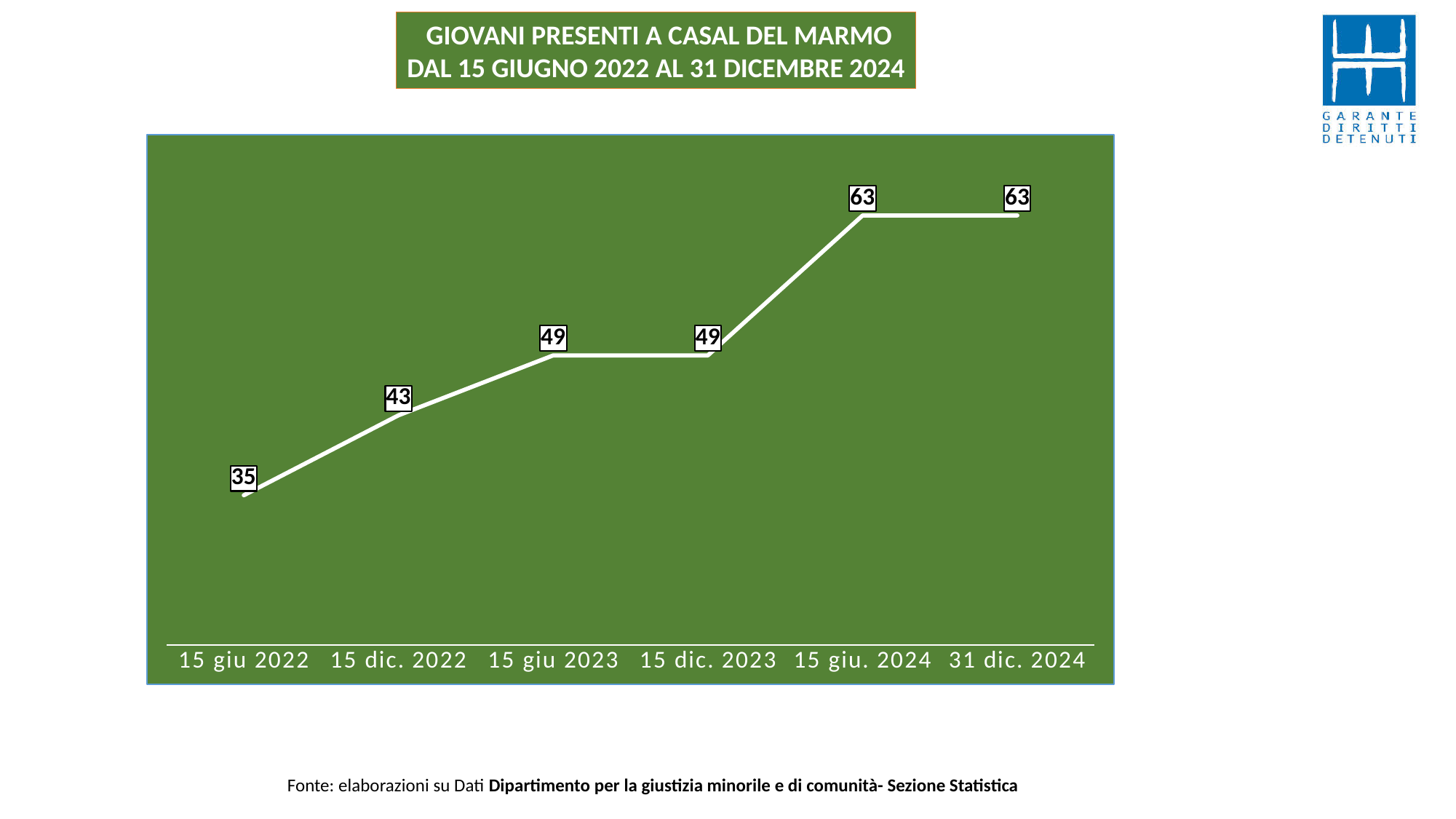
Do the values rise or fall from 15 giu 2022 to 31 dic. 2024? rise Which date has the lowest value? 15 giu 2022 What is the value for 15 dic. 2022? 43 What kind of chart is shown on the slide? line chart What is the value for 15 giu 2023? 49 Which is larger, the value for 15 dic. 2022 or the value for 15 giu 2023? 15 giu 2023 How many data points are plotted on the chart? 6 What is the title of the chart? GIOVANI PRESENTI A CASAL DEL MARMO DAL 15 GIUGNO 2022 AL 31 DICEMBRE 2024 What is the value for 31 dic. 2024? 63 What is the difference between the values for 31 dic. 2024 and 15 giu 2022? 28 What is the difference between the values for 15 giu. 2024 and 15 dic. 2023? 14 What is the value for 15 giu 2022? 35